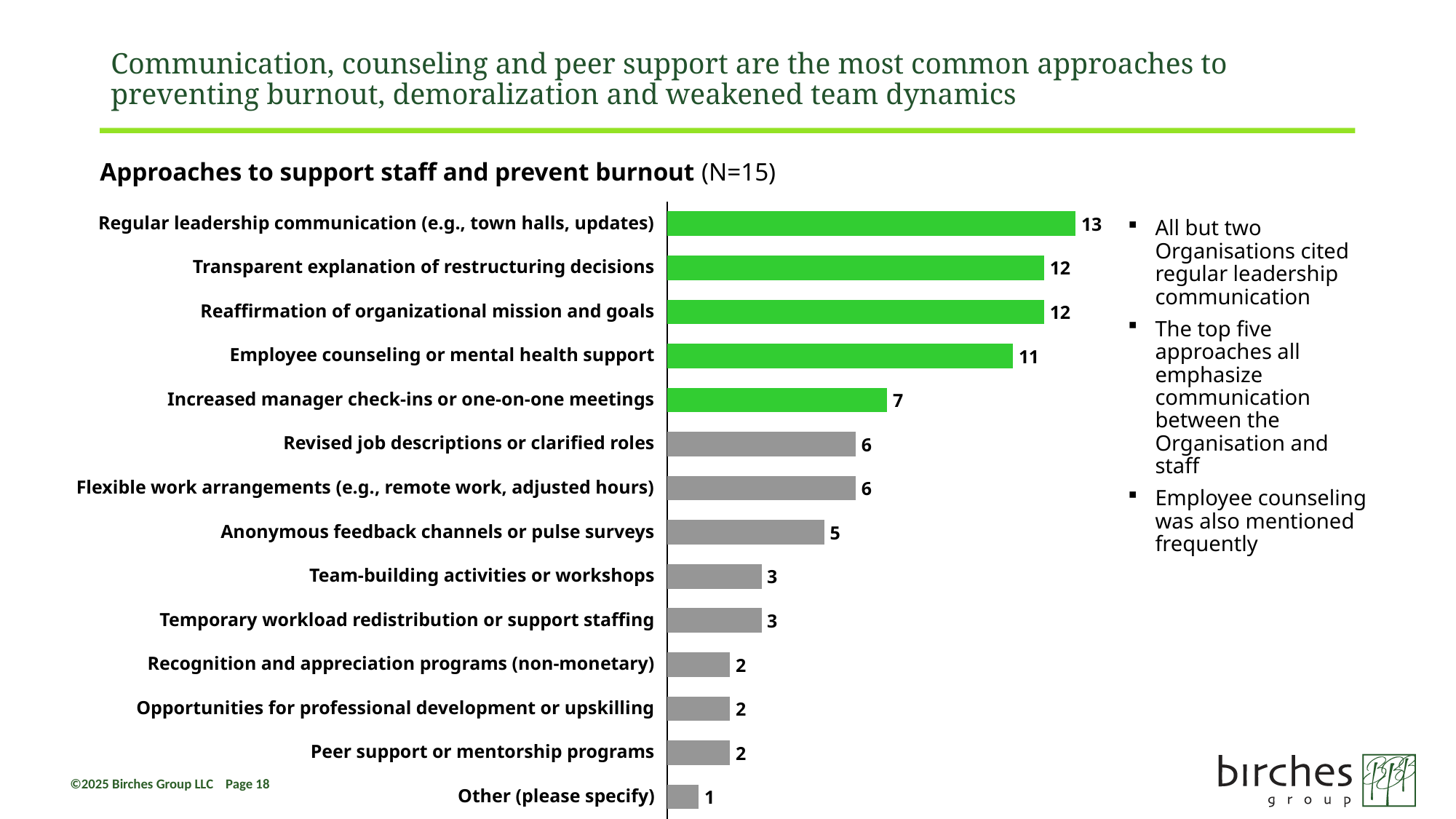
What kind of chart is shown on the slide? Bar chart What is the value for Peer support or mentorship programs? 2 How many approaches (categories) are shown in the chart? 14 What is the value for Anonymous feedback channels or pulse surveys? 5 Which approach has the highest value? Regular leadership communication (e.g., town halls, updates) What is the title of the chart? Approaches to support staff and prevent burnout (N=15) How many bars are coloured green? 5 Which is larger: the value for Revised job descriptions or clarified roles or the value for Team-building activities or workshops? Revised job descriptions or clarified roles What is the difference between the values for Regular leadership communication and Increased manager check-ins or one-on-one meetings? 6 What is the value for Employee counseling or mental health support? 11 What is the value for Regular leadership communication (e.g., town halls, updates)? 13 Which approach has the lowest value? Other (please specify)